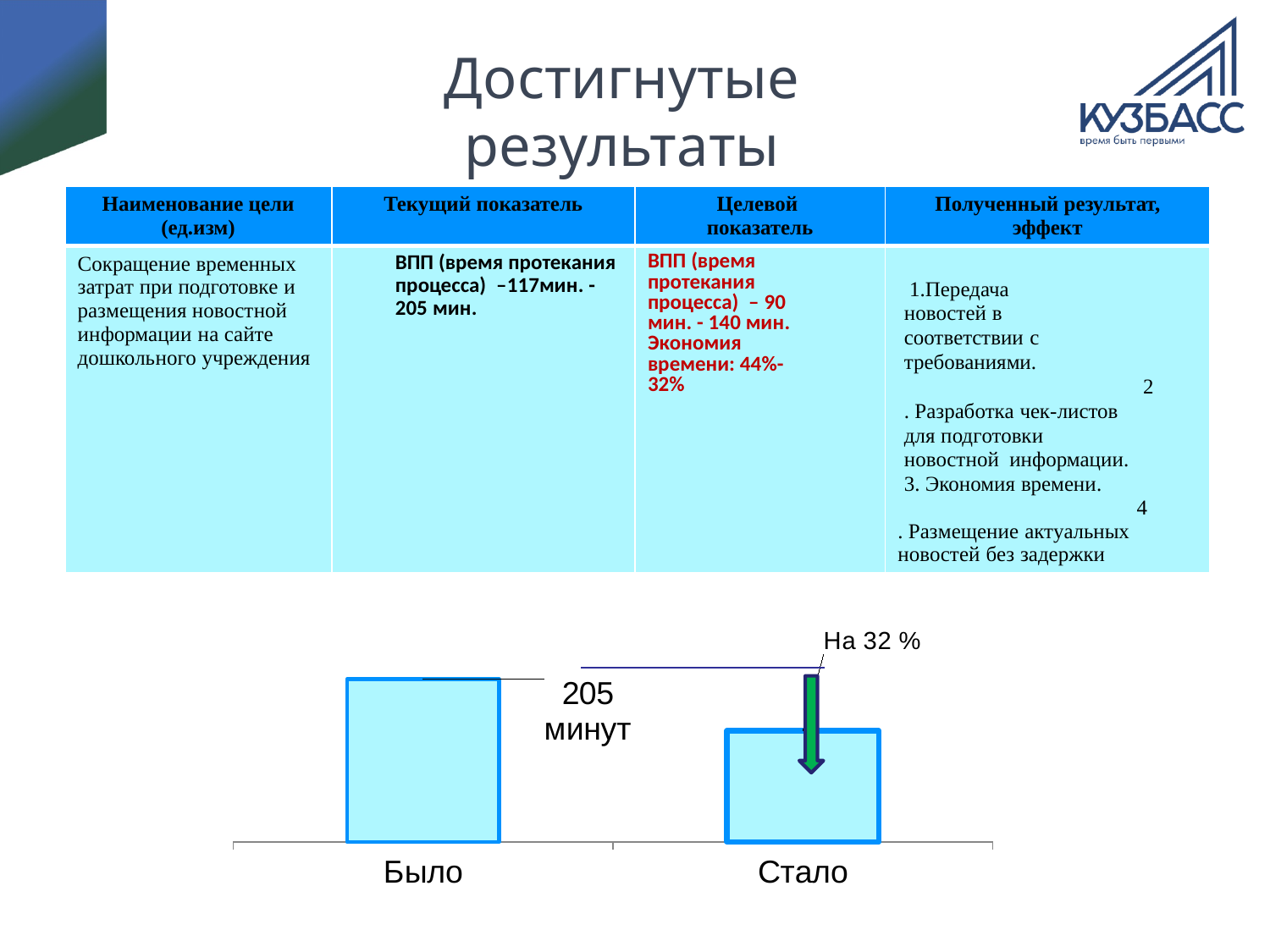
What value is printed next to the "Было" bar in the chart? 205 минут Which bar in the chart is the tallest? Было What are the two category labels on the x axis of the chart? Было, Стало Which bar in the chart is the shortest? Стало How many bars does the chart at the bottom of the slide have? 2 In the chart, is the "Было" bar or the "Стало" bar taller? Было What kind of chart is shown at the bottom of the slide? bar chart Do the bar values rise or fall from "Было" to "Стало" in the chart? fall What percentage reduction is printed next to the arrow above the "Стало" bar? На 32 %